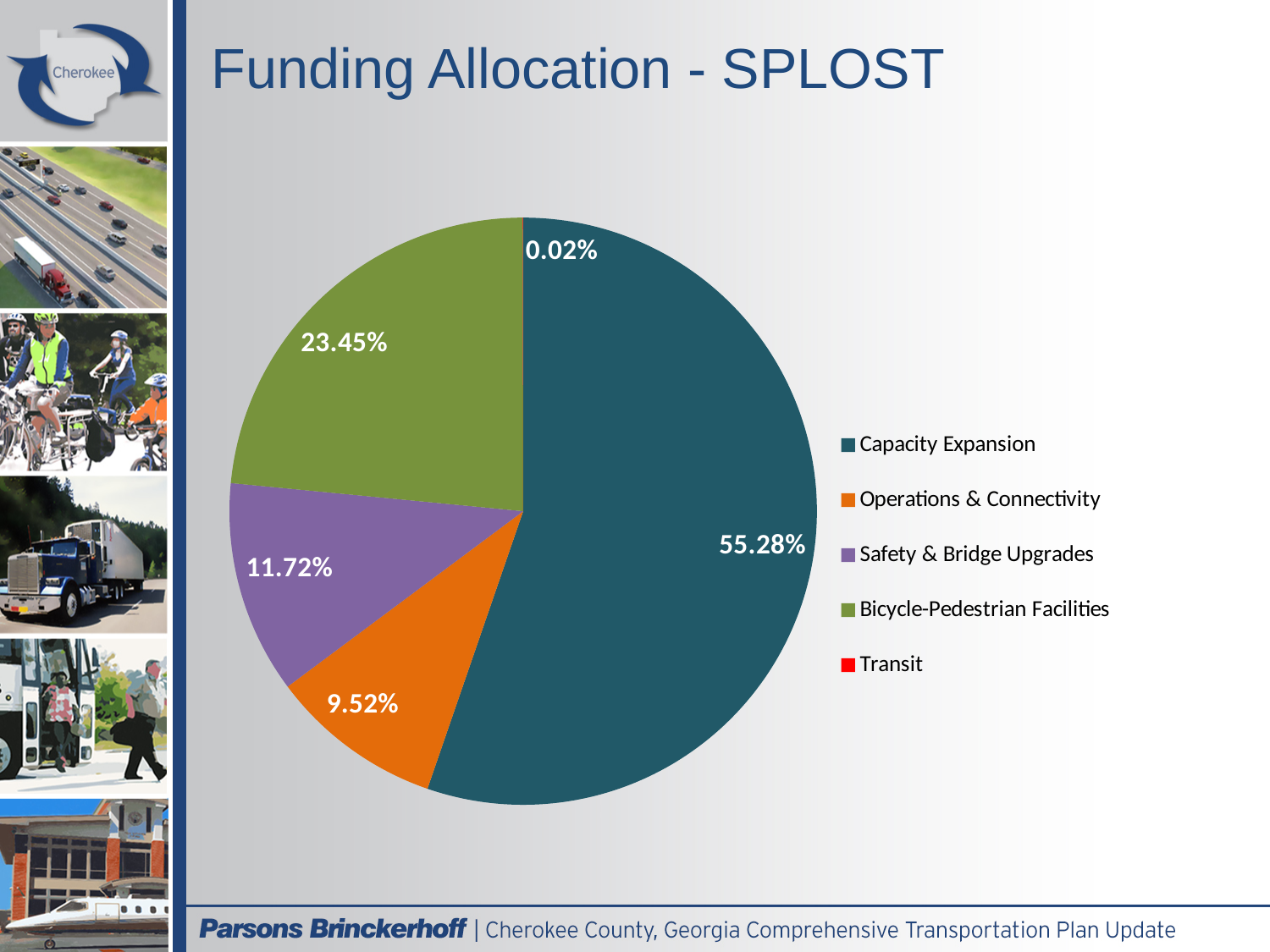
What kind of chart is shown on the slide? pie chart What share of SPLOST funding is allocated to Capacity Expansion? 55.28% How many categories does the legend list? 5 Which receives a larger share of SPLOST funding, Safety & Bridge Upgrades or Operations & Connectivity? Safety & Bridge Upgrades What is the difference between the shares for Capacity Expansion and Bicycle-Pedestrian Facilities? 31.83% Which category receives the largest share of SPLOST funding? Capacity Expansion What share of SPLOST funding is allocated to Safety & Bridge Upgrades? 11.72% What share of SPLOST funding is allocated to Bicycle-Pedestrian Facilities? 23.45% What share of SPLOST funding is allocated to Operations & Connectivity? 9.52% Which category receives the smallest share of SPLOST funding? Transit What is the title of the slide containing the pie chart? Funding Allocation - SPLOST What share of SPLOST funding is allocated to Transit? 0.02%